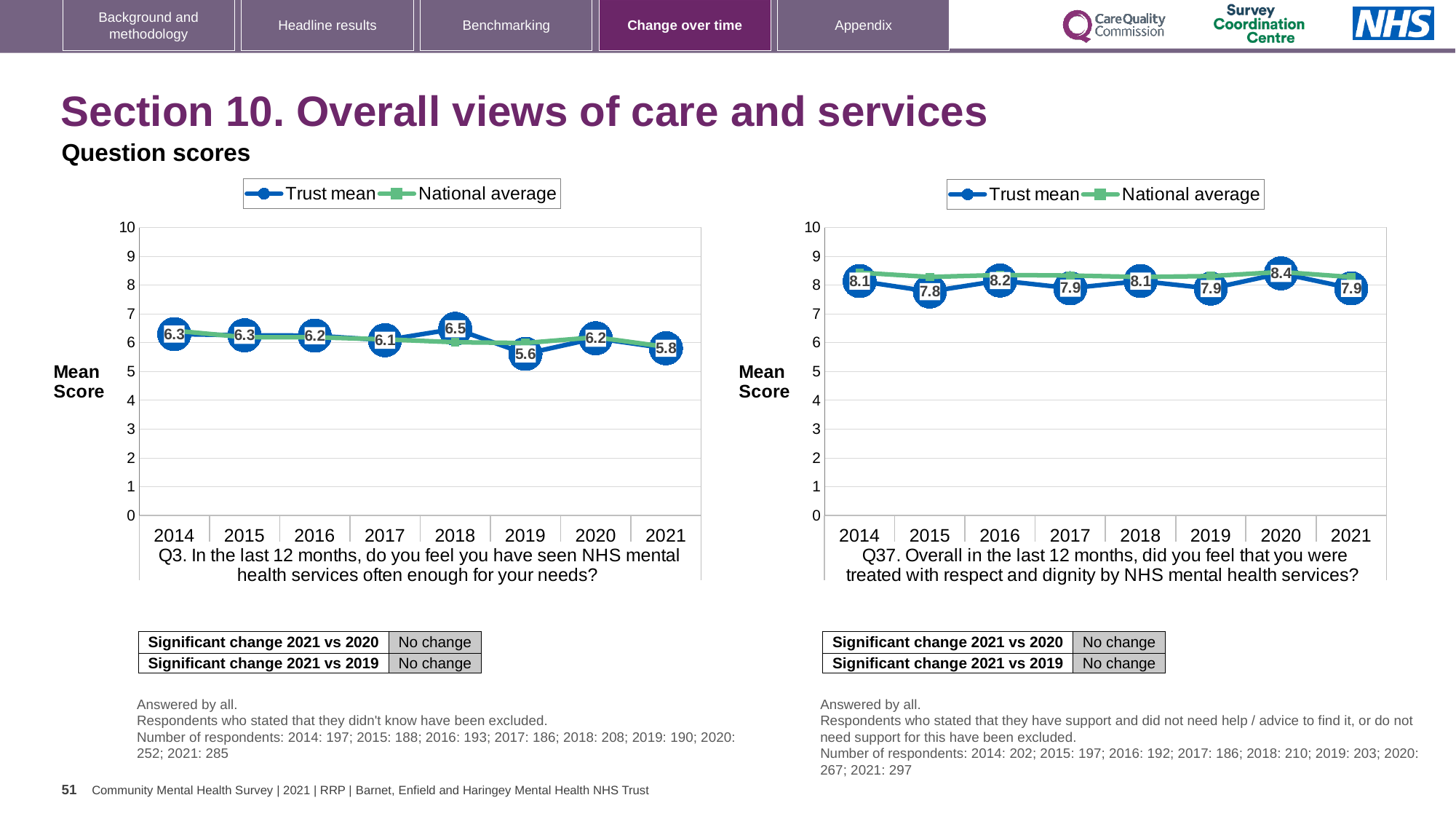
In the left chart (Q3), what is the Trust mean score for 2021? 5.8 In the right chart (Q37), what is the Trust mean score for 2015? 7.8 How many years are shown on the x axis of the left chart (Q3)? 8 In the right chart (Q37), is the Trust mean score for 2016 larger or smaller than the score for 2015? larger In the left chart (Q3), what is the difference between the Trust mean scores for 2018 and 2019? 0.9 How many series does the legend of the right chart (Q37) list? 2 In the left chart (Q3), which year has the lowest Trust mean score? 2019 In the right chart (Q37), what is the Trust mean score for 2020? 8.4 In the left chart (Q3), which year has the highest Trust mean score? 2018 In the left chart (Q3), what is the Trust mean score for 2018? 6.5 What type of chart is the left chart (Q3)? Line chart In the right chart (Q37), which year has the highest Trust mean score? 2020